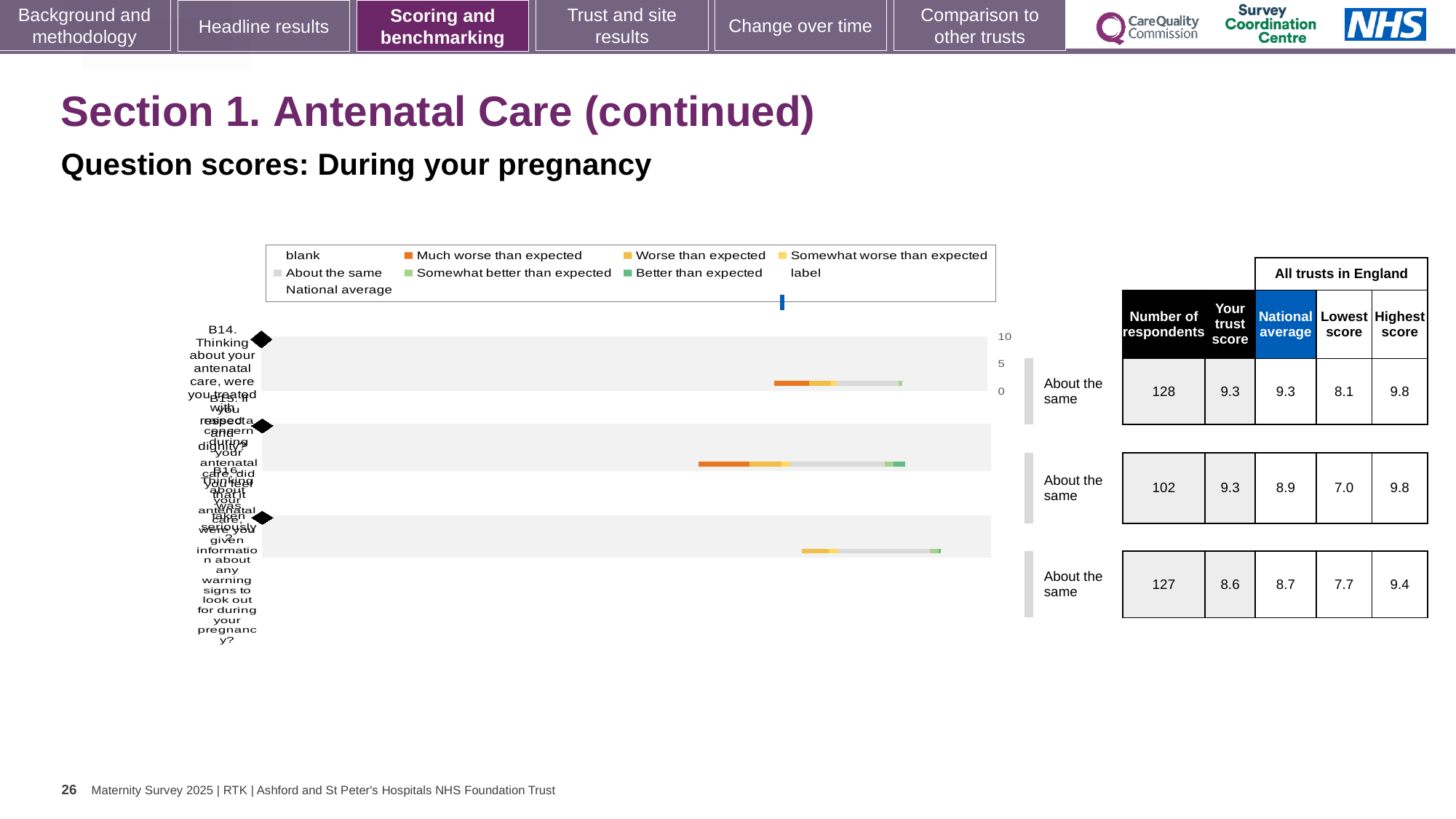
In the second row of the table, which is larger: 'Your trust score' or 'National average'? Your trust score In the table to the right of the chart, what is the number of respondents in the first row? 128 What kind of chart is shown on the slide? bar chart What benchmark label is shown next to each of the three bars? About the same How many entries does the chart legend list? 9 In the second row of the table, what is the difference between 'Your trust score' and 'National average'? 0.4 What is the highest tick value shown on the chart's axis? 10 In the table to the right of the chart, what is the lowest score in the third row? 7.7 In the table to the right of the chart, what is the 'Your trust score' in the second row? 9.3 What colour does the legend use for 'Much worse than expected'? orange How many horizontal bars are plotted in the chart? 3 In the table to the right of the chart, what is the highest score in the first row? 9.8